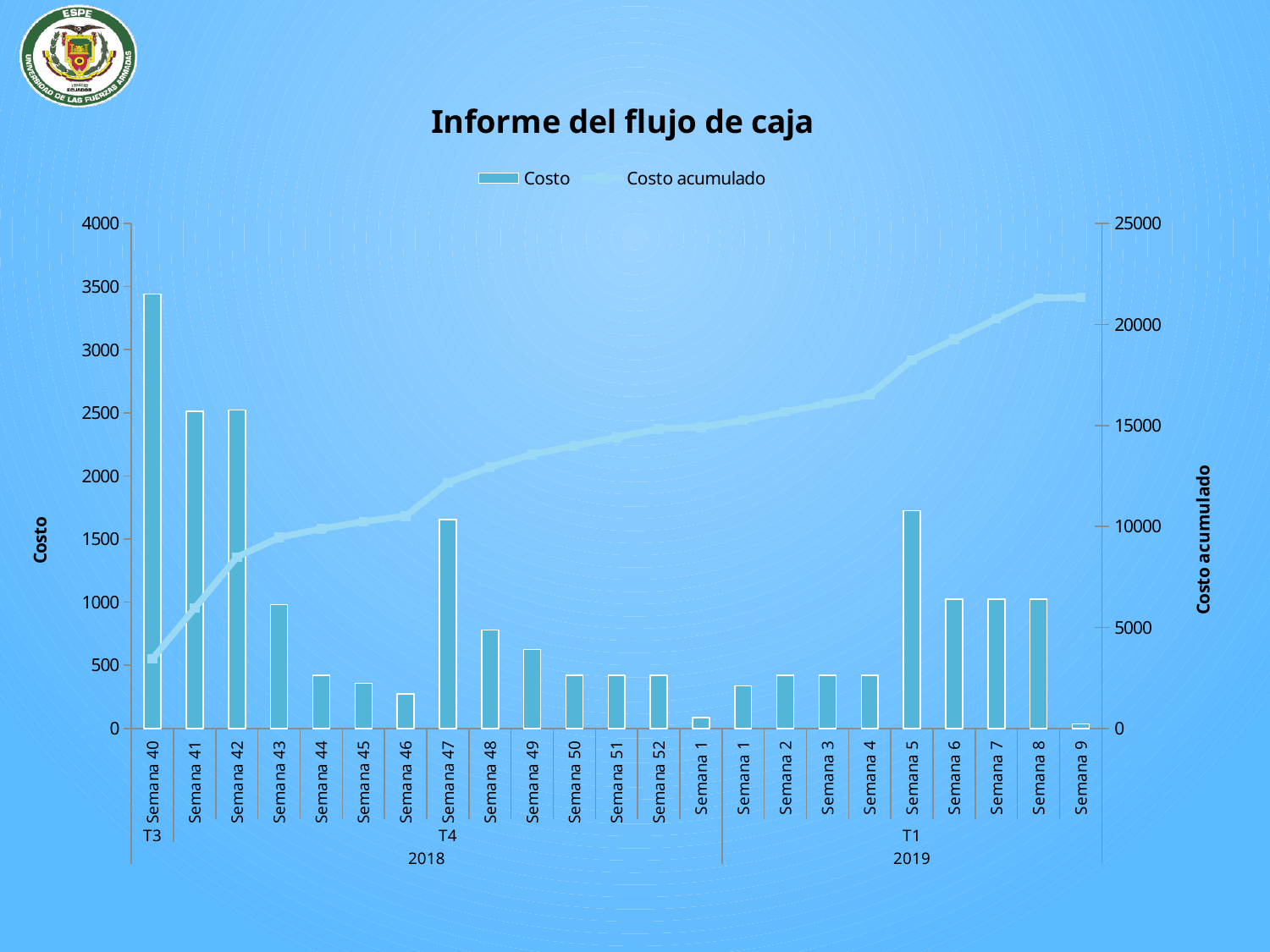
Is the Costo value for Semana 46 greater or less than 500? less Which week has the highest Costo bar? Semana 40 What kind of chart is shown on the slide? A combined bar and line chart How many series does the legend list? 2 Is the Costo value for Semana 40 greater or less than 3000? greater Which week has the lowest Costo bar? Semana 9 (2019) Is the Costo acumulado value at Semana 9 (2019) greater or less than 20000? greater What is the title of the chart? Informe del flujo de caja Does the Costo acumulado line rise or fall from Semana 40 to Semana 9? It rises Which has a larger Costo value, Semana 47 or Semana 48? Semana 47